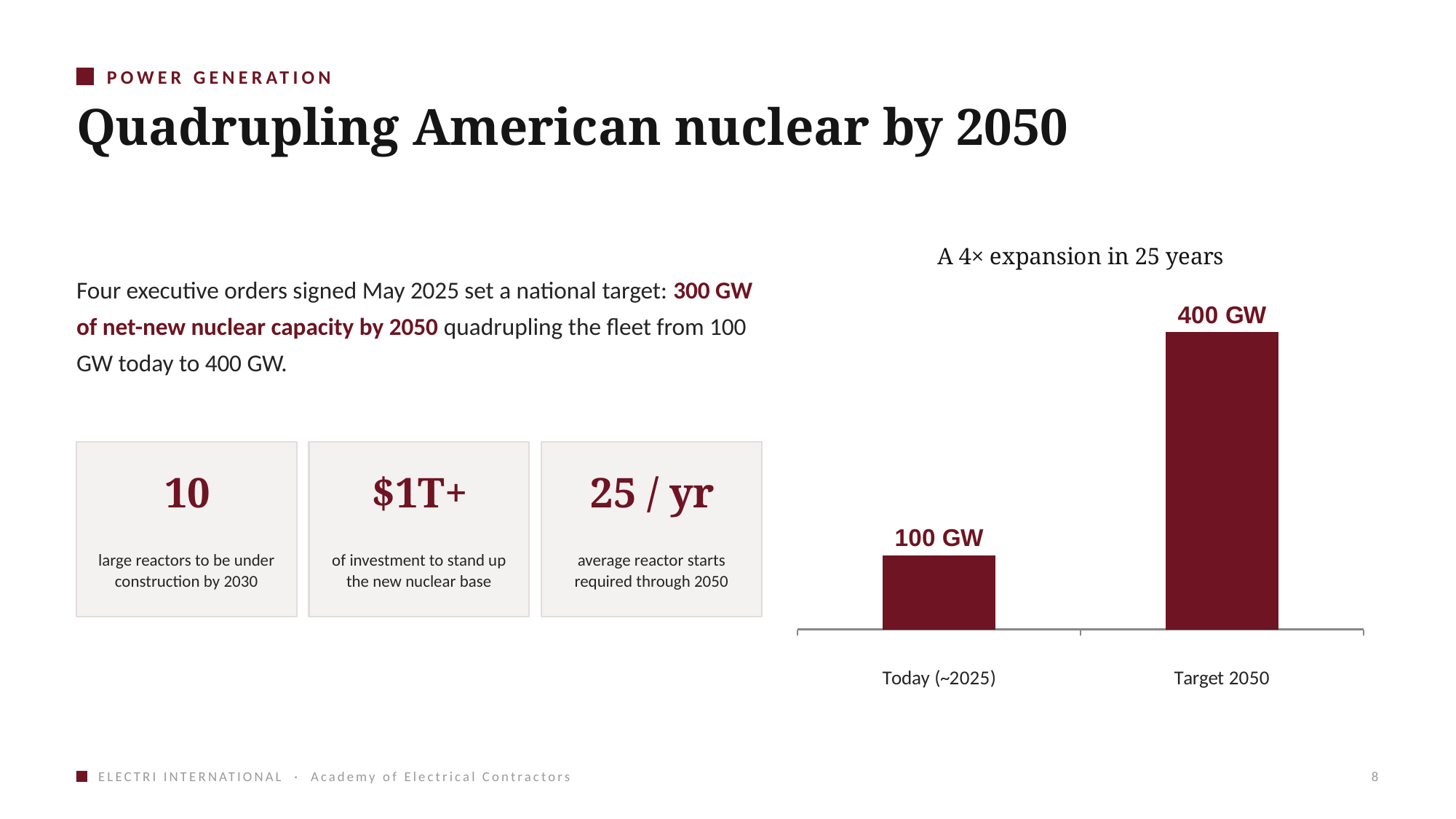
What is the value for Target 2050? 400 GW What colour are the bars in the chart? Dark red How many categories are shown in the chart? 2 Which is larger, the value for Today (~2025) or the value for Target 2050? Target 2050 What is the difference between the Target 2050 value and the Today (~2025) value? 300 GW Do the values rise or fall from Today (~2025) to Target 2050? Rise Which category has the highest value? Target 2050 What kind of chart is shown on the slide? Bar chart What is the value for Today (~2025)? 100 GW What is the title of the chart? A 4× expansion in 25 years Which category has the lowest value? Today (~2025)